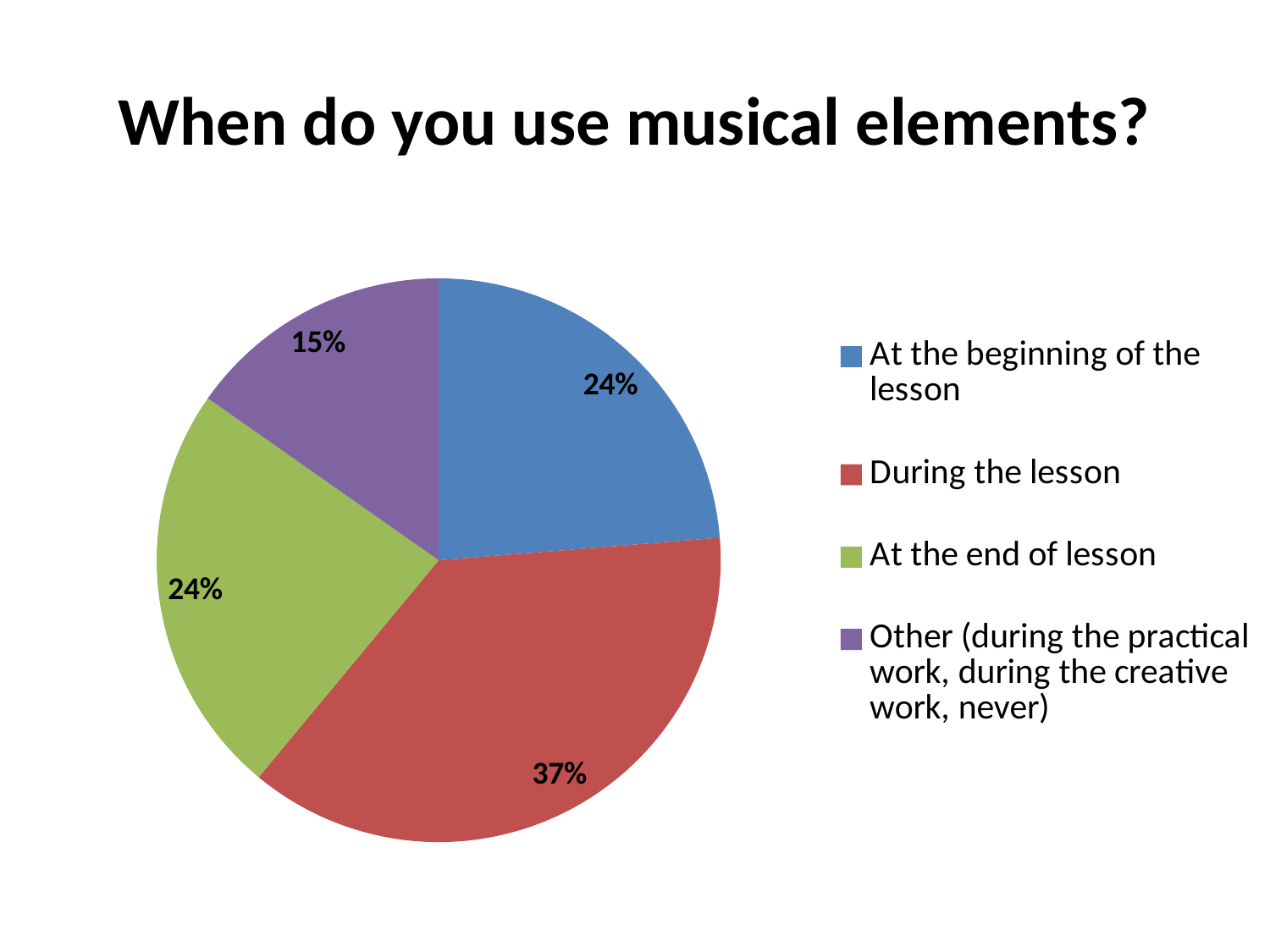
What share of the pie is 'At the end of lesson'? 24% How many categories does the pie chart have? 4 Which is larger: the slice for 'During the lesson' or the slice for 'At the end of lesson'? During the lesson What is the difference in percentage points between 'During the lesson' and 'Other'? 22 What share of the pie is 'At the beginning of the lesson'? 24% What colour is the slice for 'At the end of lesson'? green What is the title of the chart? When do you use musical elements? Which category has the largest slice of the pie? During the lesson What share of the pie is 'During the lesson'? 37% Which category has the smallest slice of the pie? Other (during the practical work, during the creative work, never) What kind of chart is shown on the slide? pie chart